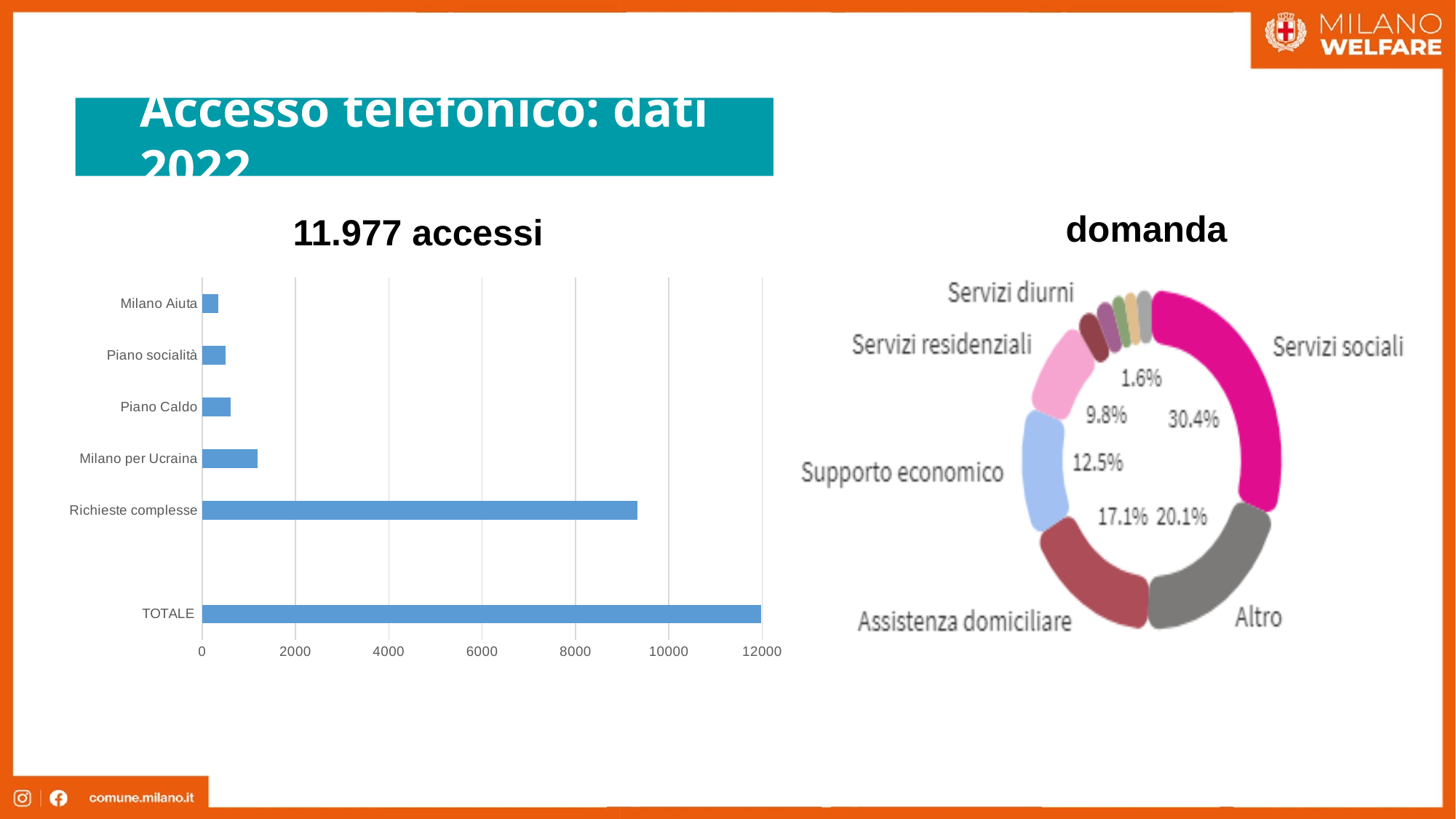
What kind of chart is the one titled "11.977 accessi"? bar chart In the "11.977 accessi" chart, which category has the longest bar? TOTALE What kind of chart is the one titled "domanda"? doughnut chart In the "11.977 accessi" chart, is the value for Richieste complesse greater or less than 8000? greater In the "domanda" chart, what percentage is shown for Servizi sociali? 30.4% In the "domanda" chart, which category has the largest share? Servizi sociali In the "domanda" chart, what is the difference between the shares of Servizi sociali and Altro? 10.3% In the "domanda" chart, what percentage is shown for Supporto economico? 12.5% In the "11.977 accessi" chart, which category has the shortest bar? Milano Aiuta In the "11.977 accessi" chart, is the value for Milano per Ucraina greater or less than 2000? less In the "11.977 accessi" chart, how many categories are shown on the vertical axis? 6 In the "11.977 accessi" chart, which bar is longer: Milano per Ucraina or Piano Caldo? Milano per Ucraina